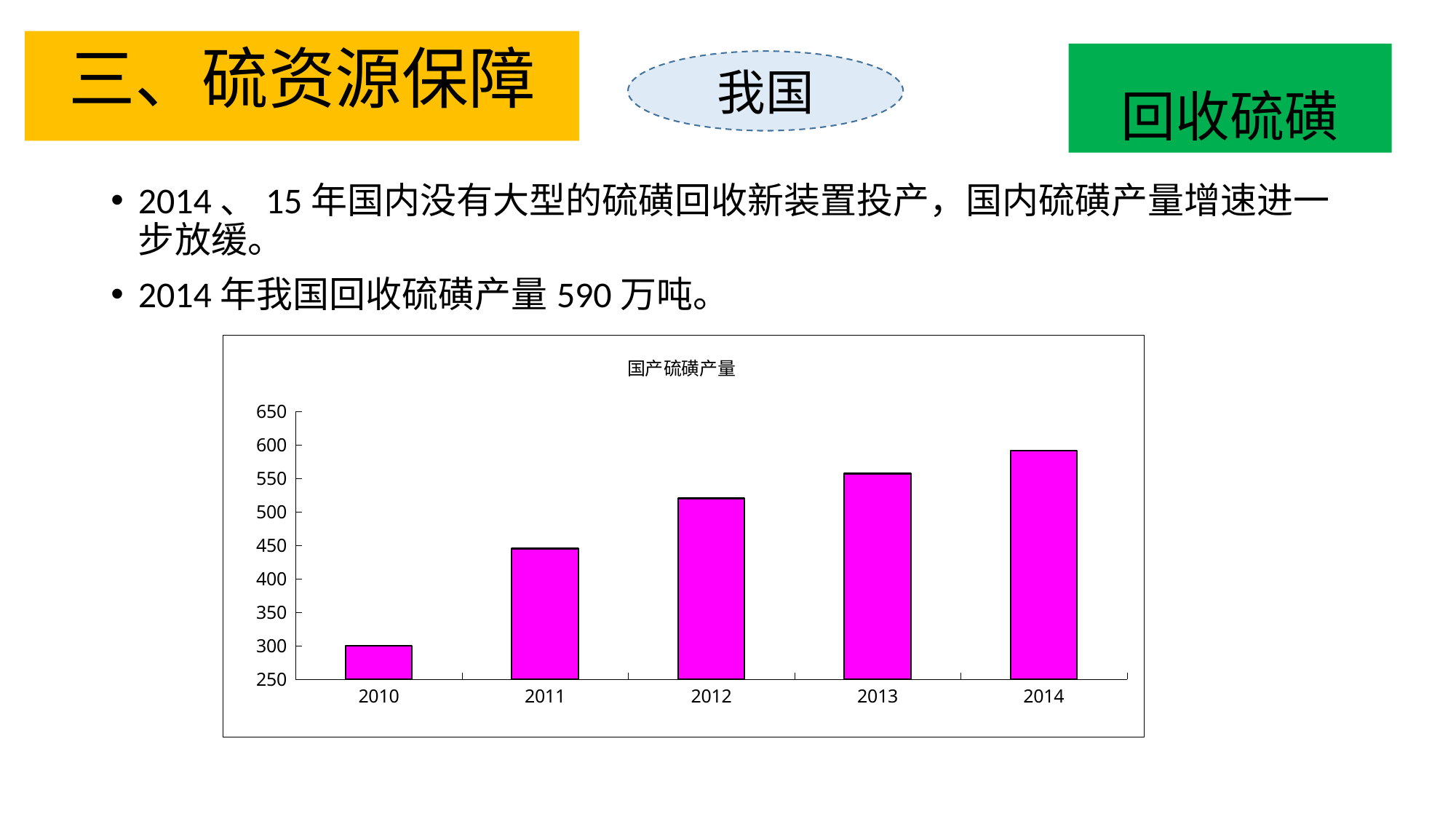
Is the value for 2012 greater or less than 500? greater How many years are shown on the x axis of the chart? 5 Is the value for 2013 greater or less than 500? greater What colour are the bars in the chart? magenta Is the value for 2014 greater or less than 600? less Which is larger, the value for 2011 or the value for 2013? 2013 Which year has the lowest value in the chart? 2010 Do the values rise or fall from 2010 to 2014? rise Which year has the highest value in the chart? 2014 What is the title of the chart? 国产硫磺产量 What kind of chart is shown on the slide? bar chart